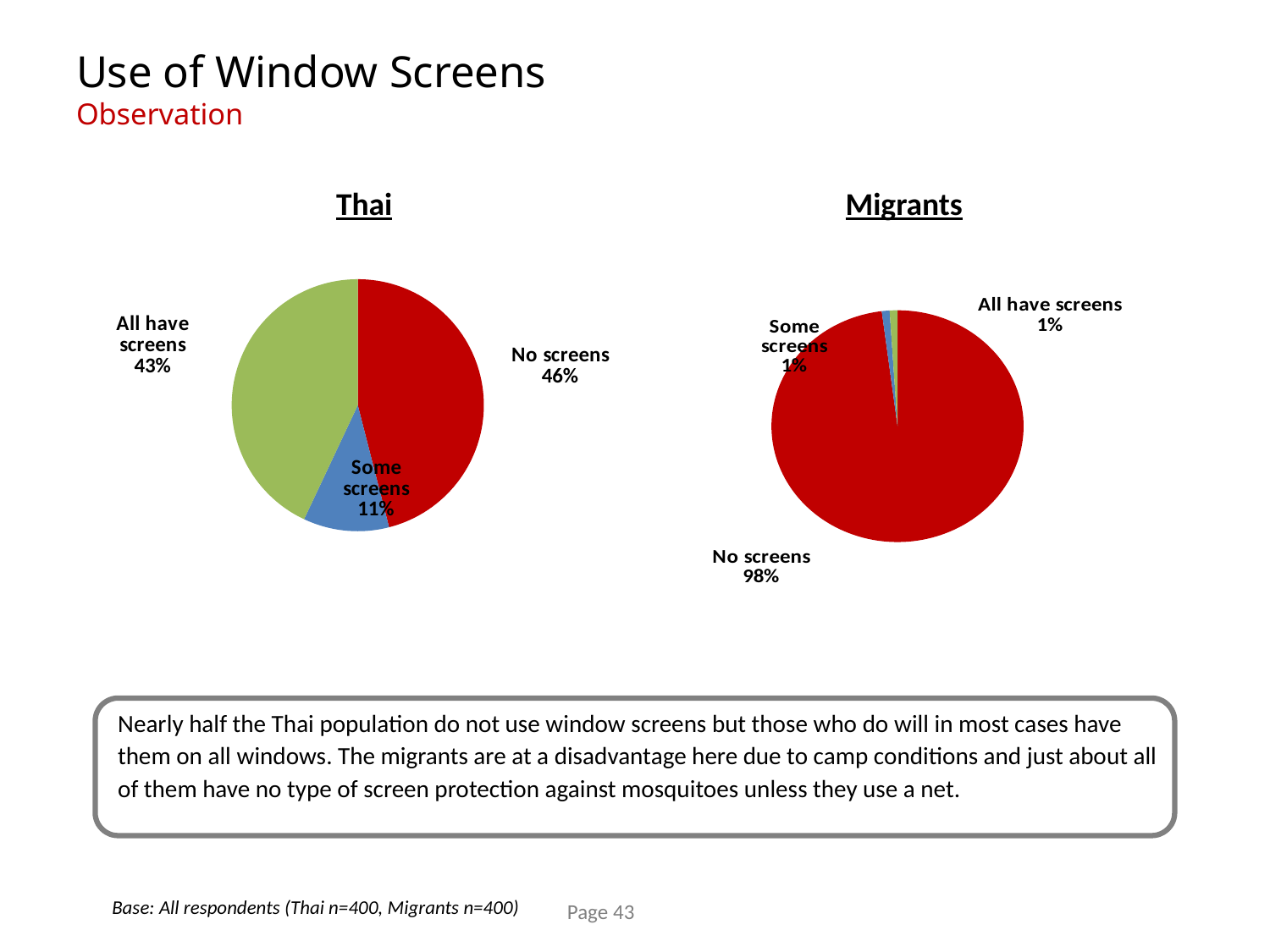
In the Thai pie chart, what share is labelled 'Some screens'? 11% In the Thai pie chart, which category has the largest share? No screens What is the difference in percentage points between 'No screens' in the Migrants chart and 'No screens' in the Thai chart? 52 percentage points In the Thai pie chart, what is the difference between the 'No screens' and 'All have screens' shares? 3 percentage points How many slices does the Thai pie chart have? 3 In the Thai pie chart, what percentage of respondents have no screens? 46% In the Migrants pie chart, which category has the largest share? No screens In the Migrants pie chart, what percentage of respondents have no screens? 98% In the Thai pie chart, what percentage of respondents have screens on all windows? 43% What type of chart is used for the Thai and Migrants data? Pie chart In the Migrants pie chart, what percentage of respondents have all screens? 1% In the Thai pie chart, which category has the smallest share? Some screens